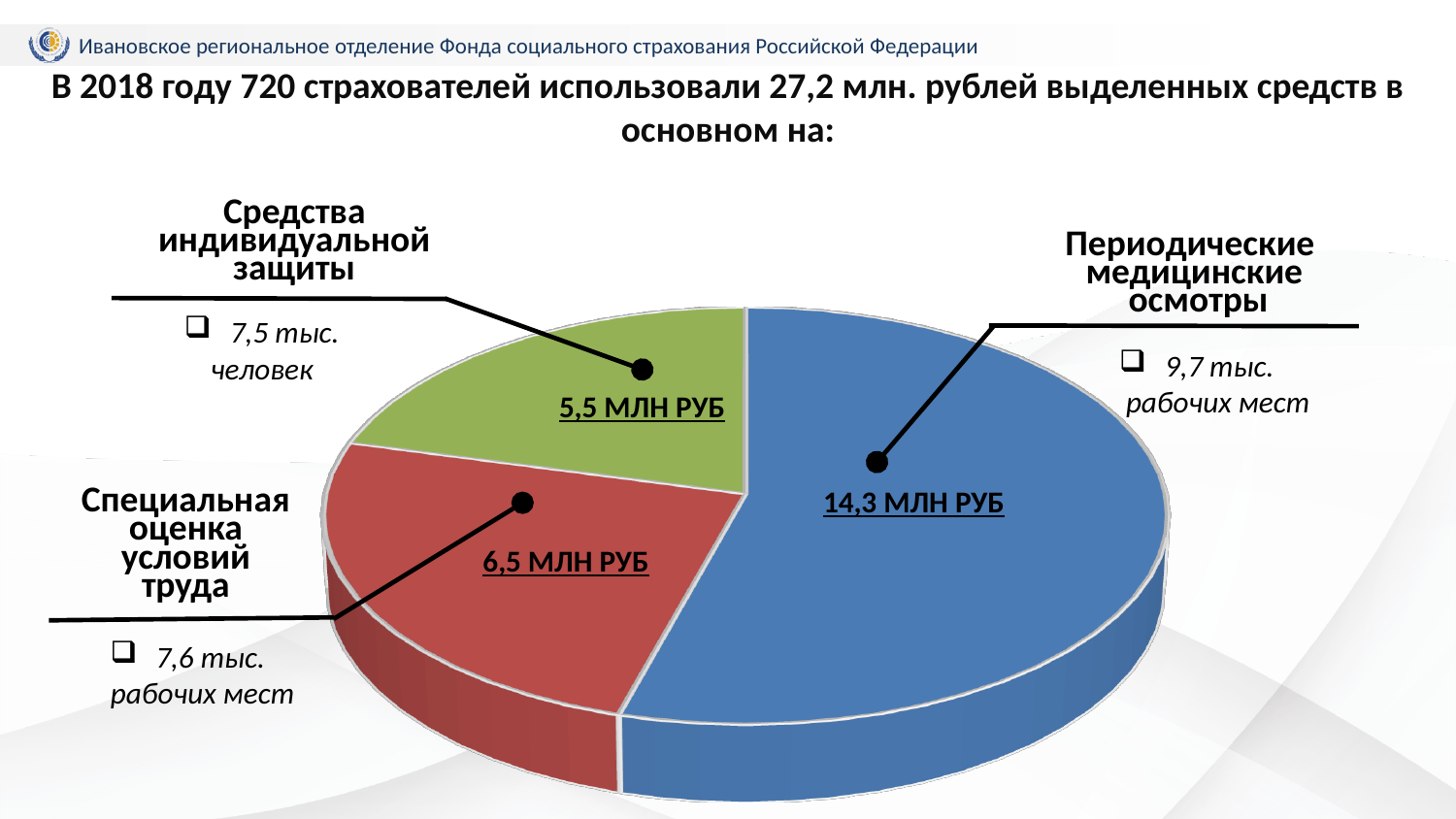
What value is shown for the slice «Средства индивидуальной защиты»? 5,5 МЛН РУБ What type of chart is shown on the slide? Pie chart How many slices does the pie chart have? 3 What value is shown for the slice «Периодические медицинские осмотры»? 14,3 МЛН РУБ How many workplaces («рабочих мест») are noted next to the «Периодические медицинские осмотры» slice? 9,7 тыс. Which category has the largest slice of the pie? Периодические медицинские осмотры Which is larger: the value for «Специальная оценка условий труда» or for «Средства индивидуальной защиты»? Специальная оценка условий труда What value is shown for the slice «Специальная оценка условий труда»? 6,5 МЛН РУБ Which category has the smallest slice of the pie? Средства индивидуальной защиты What is the difference between the values for «Периодические медицинские осмотры» and «Специальная оценка условий труда»? 7,8 млн руб What colour is the slice for «Периодические медицинские осмотры»? Blue What is the difference between the values for «Специальная оценка условий труда» and «Средства индивидуальной защиты»? 1,0 млн руб